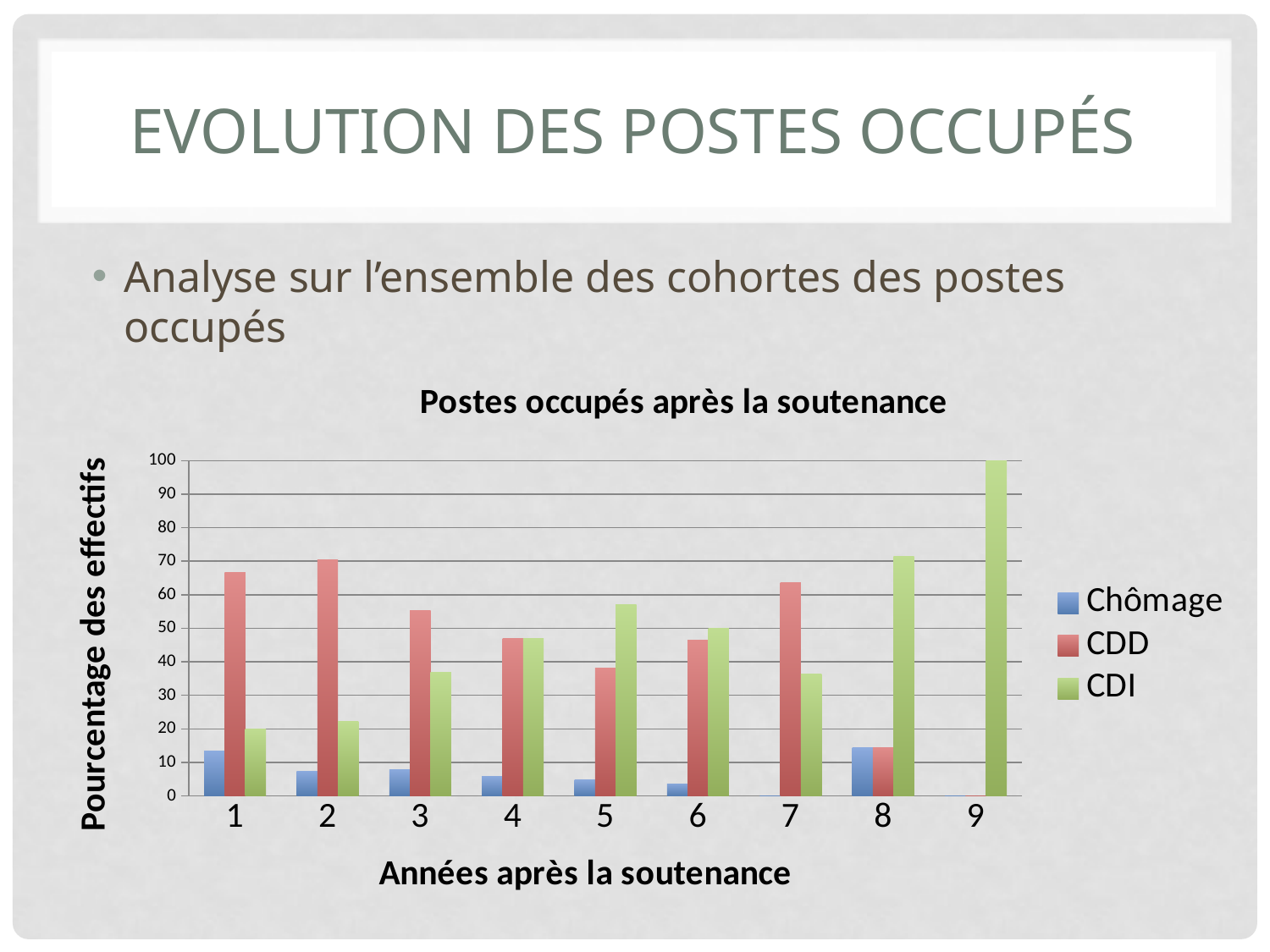
Is the value for CDI at year 1 greater or less than 30? less In which year is the CDI value highest? 9 At year 3, which is larger: CDD or CDI? CDD What is the title of the chart? Postes occupés après la soutenance Does the Chômage value rise or fall from year 1 to year 7? fall How many years (categories) are shown on the x axis of the chart? 9 What kind of chart is shown on the slide? Bar chart At year 5, which is larger: CDD or CDI? CDI How many series does the legend of the chart list? 3 In which year is the CDD value lowest? 9 What is the value for CDI at year 9? 100 Is the value for CDD at year 1 greater or less than 60? greater